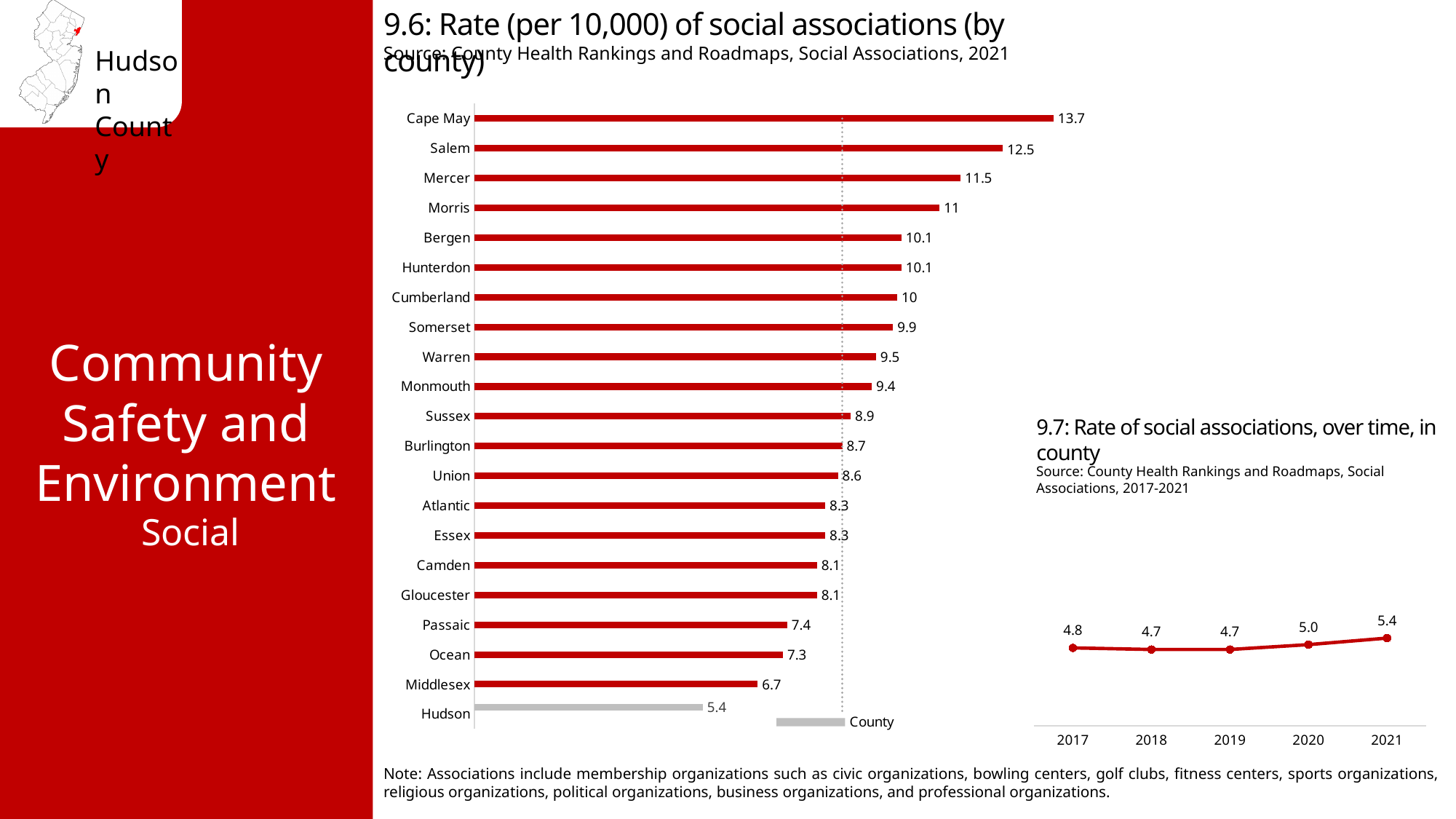
What kind of chart is '9.6: Rate (per 10,000) of social associations (by county)'? Bar chart In the chart '9.6: Rate (per 10,000) of social associations (by county)', which county has the lowest rate? Hudson In the chart '9.6: Rate (per 10,000) of social associations (by county)', which has a higher value, Mercer or Morris? Mercer In the chart '9.6: Rate (per 10,000) of social associations (by county)', what is the value for Hudson? 5.4 In the chart '9.7: Rate of social associations, over time, in county', what is the difference between the 2021 and 2017 values? 0.6 In the chart '9.6: Rate (per 10,000) of social associations (by county)', what is the value for Cape May? 13.7 In the chart '9.7: Rate of social associations, over time, in county', which year has the lowest value? 2018 and 2019 (both 4.7) In the chart '9.6: Rate (per 10,000) of social associations (by county)', what is the difference between the values for Salem and Middlesex? 5.8 In the chart '9.6: Rate (per 10,000) of social associations (by county)', which county has the highest rate? Cape May What kind of chart is '9.7: Rate of social associations, over time, in county'? Line chart In the chart '9.7: Rate of social associations, over time, in county', what is the value for 2021? 5.4 How many counties are shown in the chart '9.6: Rate (per 10,000) of social associations (by county)'? 21